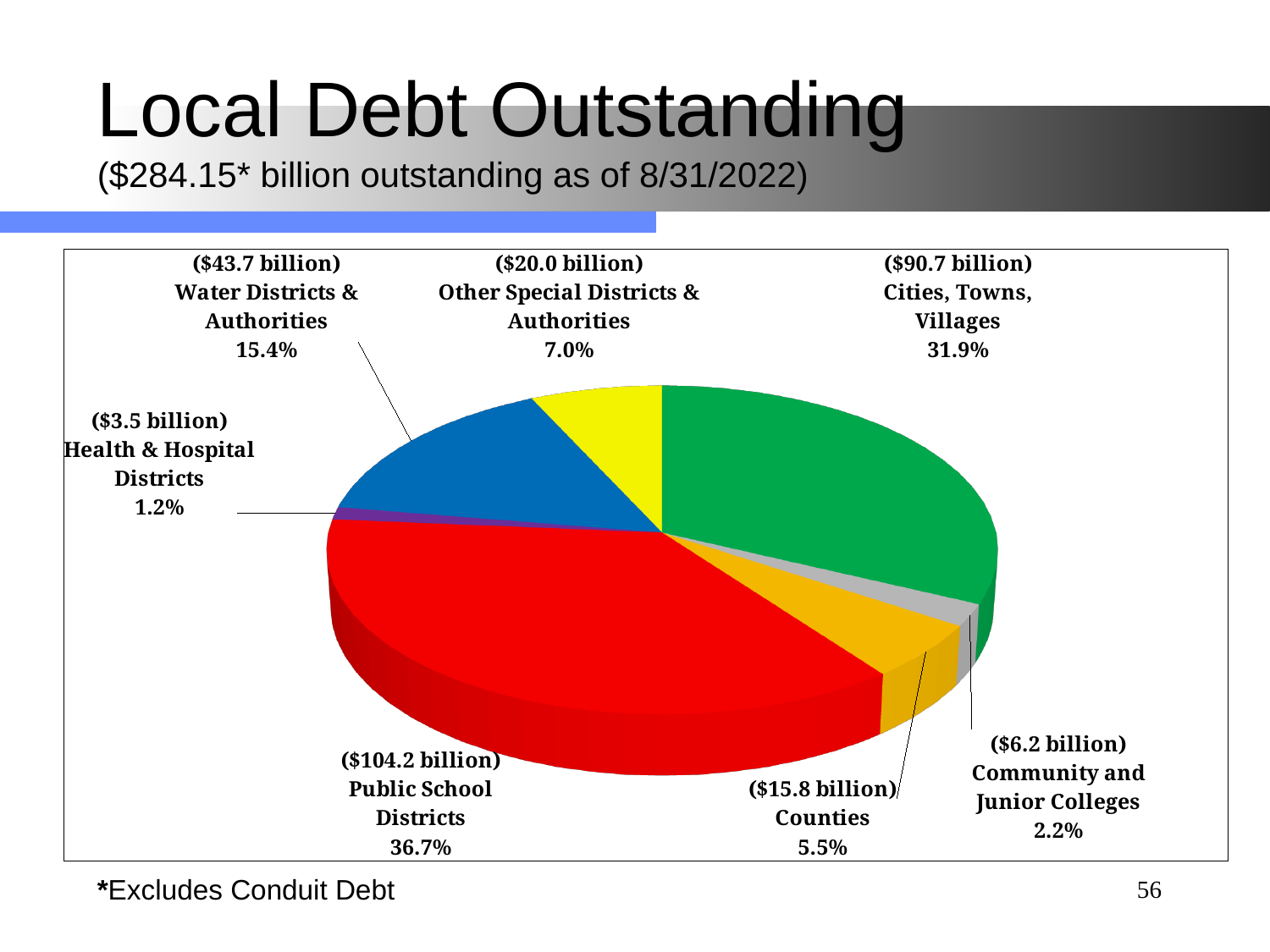
What kind of chart is shown on the slide? pie chart What is the difference in percentage share between Cities, Towns, Villages and Public School Districts? 4.8% What share of local debt outstanding is held by Public School Districts? 36.7% Which category has the largest share of local debt outstanding? Public School Districts What is the title of the chart on the slide? Local Debt Outstanding How many categories are shown in the pie chart? 7 What percentage of local debt outstanding is attributed to Water Districts & Authorities? 15.4% Which is larger, the share for Counties or the share for Community and Junior Colleges? Counties What is the dollar amount of debt outstanding for Cities, Towns, Villages? $90.7 billion What is the difference in dollar amount between Water Districts & Authorities and Other Special Districts & Authorities? $23.7 billion What is the dollar amount of debt outstanding for Health & Hospital Districts? $3.5 billion Which category has the smallest share of local debt outstanding? Health & Hospital Districts